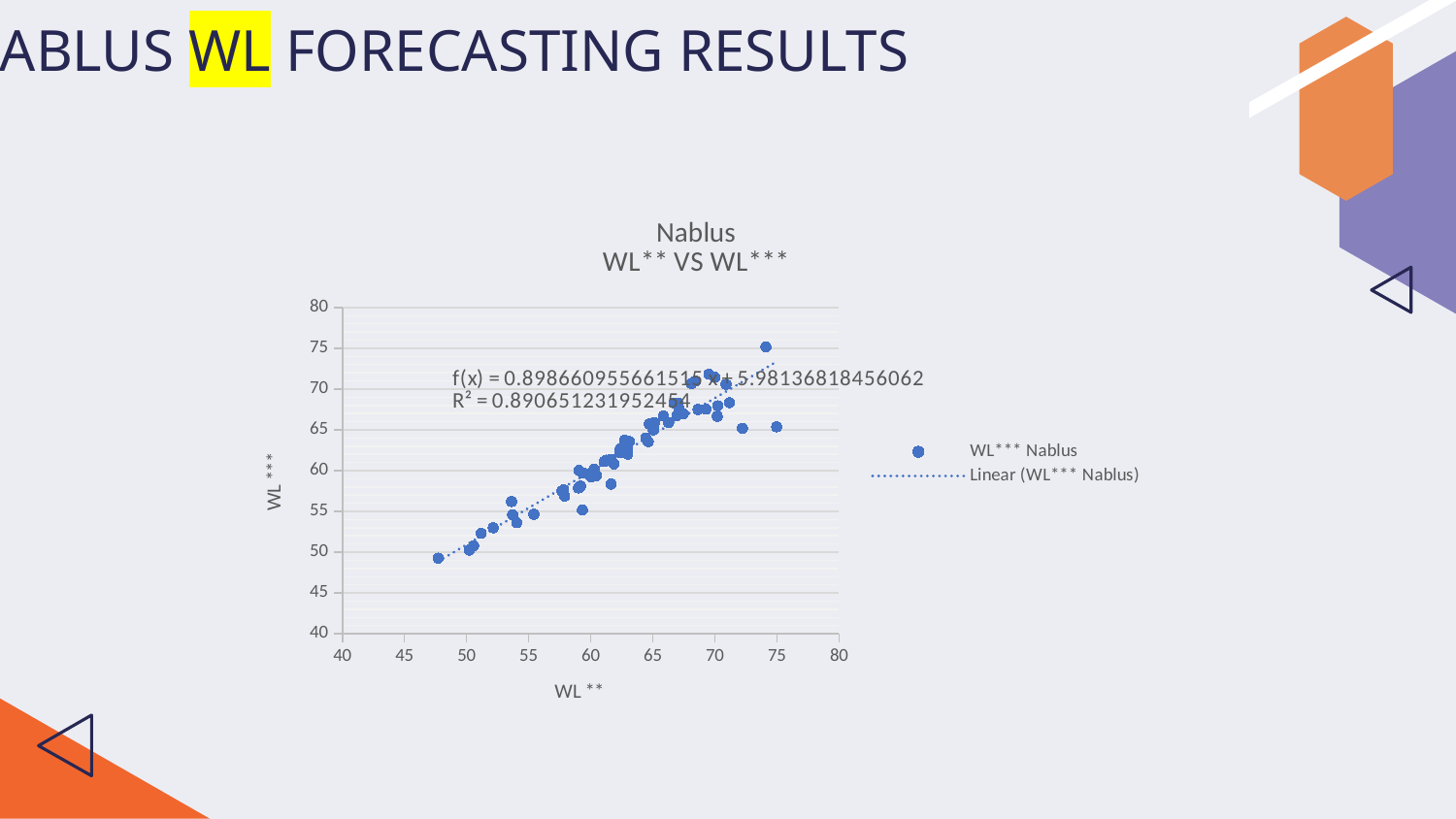
What kind of chart is shown on the slide? scatter chart Do the plotted WL*** values generally rise or fall as WL** increases along the x axis? rise What is the slope of the linear trendline equation printed on the chart? 0.898660955661515 What is the title of the chart? Nablus WL** VS WL*** What is the maximum value shown on the y axis of the chart? 80 Is the highest plotted WL*** value greater or less than 70? greater How many entries does the chart legend list? 2 What is the label on the x axis of the chart? WL ** What is the intercept of the linear trendline equation printed on the chart? 5.98136818456062 What R² value is printed on the chart? 0.890651231952454 Is the lowest plotted WL*** value greater or less than 55? less